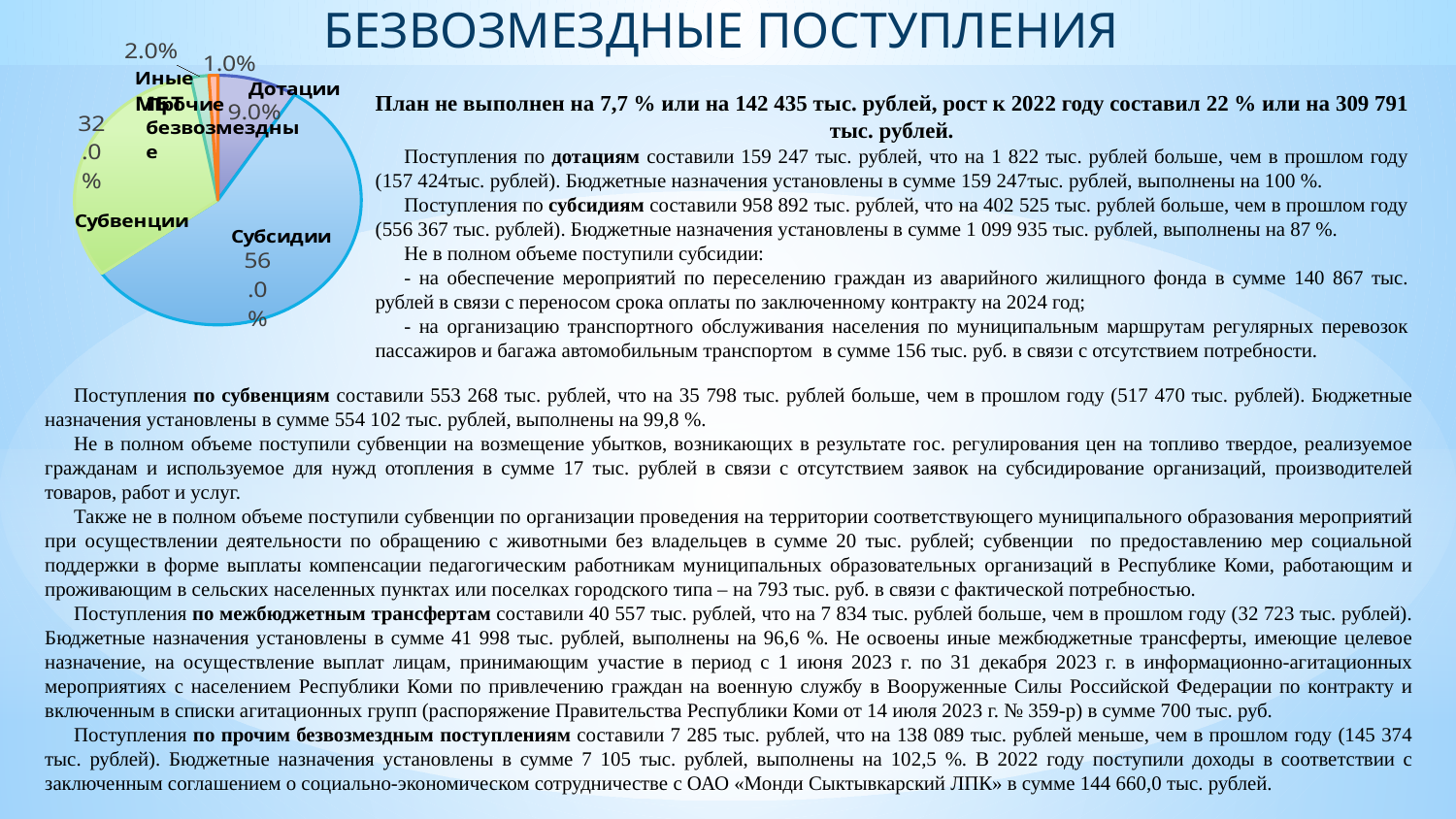
What percentage of the pie chart does Дотации account for? 9.0% Which category has the largest share of the pie chart? Субсидии Which category has the smallest share of the pie chart? Прочие безвозмездные What is the difference in percentage points between the Субсидии and Субвенции shares? 24.0 What percentage of the pie chart does Иные МБТ account for? 2.0% Which share is larger in the pie chart, Субвенции or Дотации? Субвенции What percentage of the pie chart does Субсидии account for? 56.0% How many slices does the pie chart have? 5 What is the title of the slide containing the pie chart? БЕЗВОЗМЕЗДНЫЕ ПОСТУПЛЕНИЯ What type of chart is shown on the slide? Pie chart What percentage of the pie chart does Прочие безвозмездные account for? 1.0% What percentage of the pie chart does Субвенции account for? 32.0%